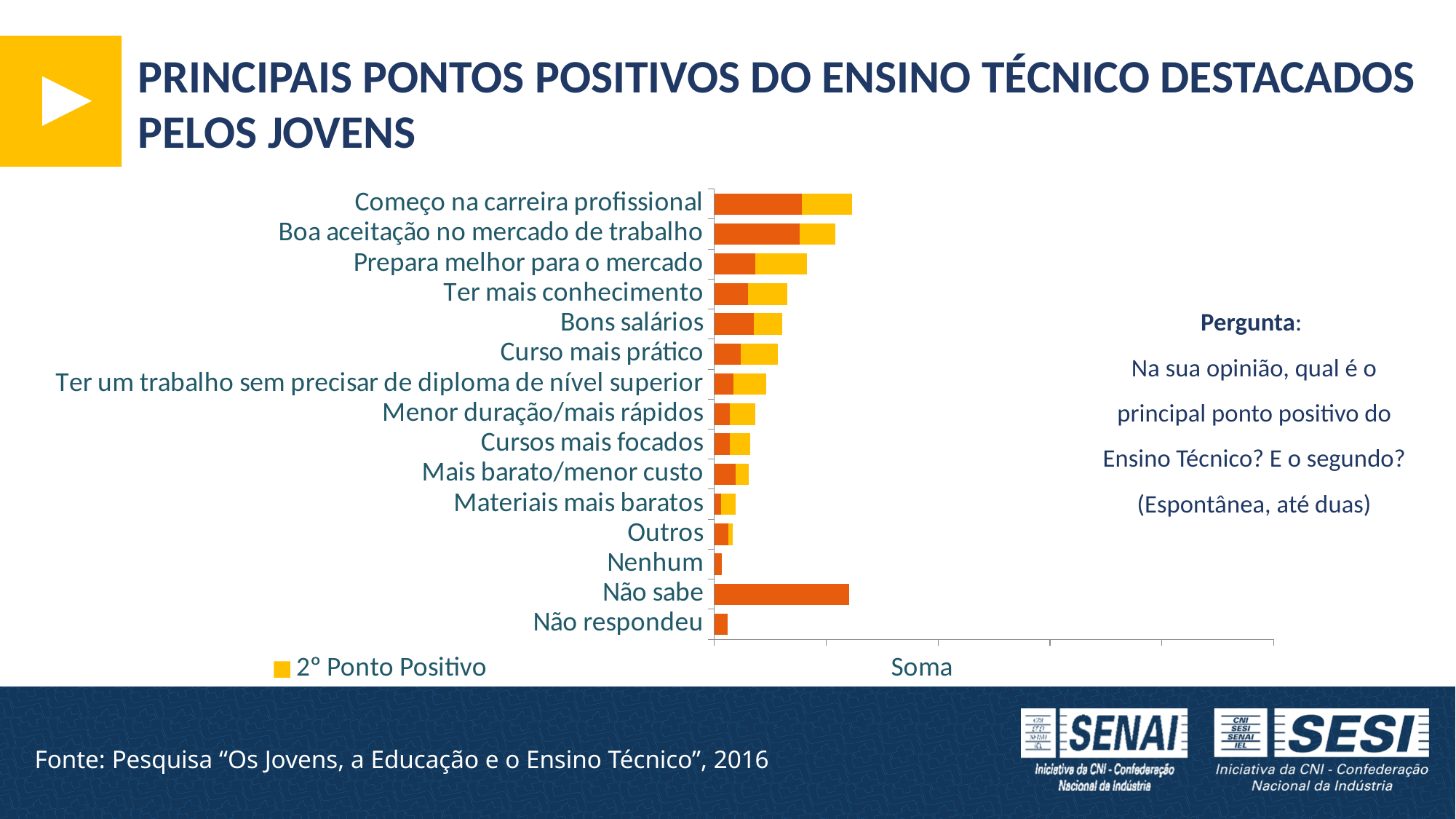
Which category has the shortest bar in the chart? Nenhum Does the bar for "Não sabe" include a yellow "2° Ponto Positivo" segment? No Which bar is longer: "Mais barato/menor custo" or "Nenhum"? Mais barato/menor custo Which bar is longer: "Ter mais conhecimento" or "Cursos mais focados"? Ter mais conhecimento What kind of chart is shown on the slide? Bar chart Which bar is longer: "Não sabe" or "Não respondeu"? Não sabe Which category is listed first (at the top) of the chart? Começo na carreira profissional What colour is used for the "2° Ponto Positivo" series in the legend? Yellow How many categories are listed on the vertical axis of the chart? 15